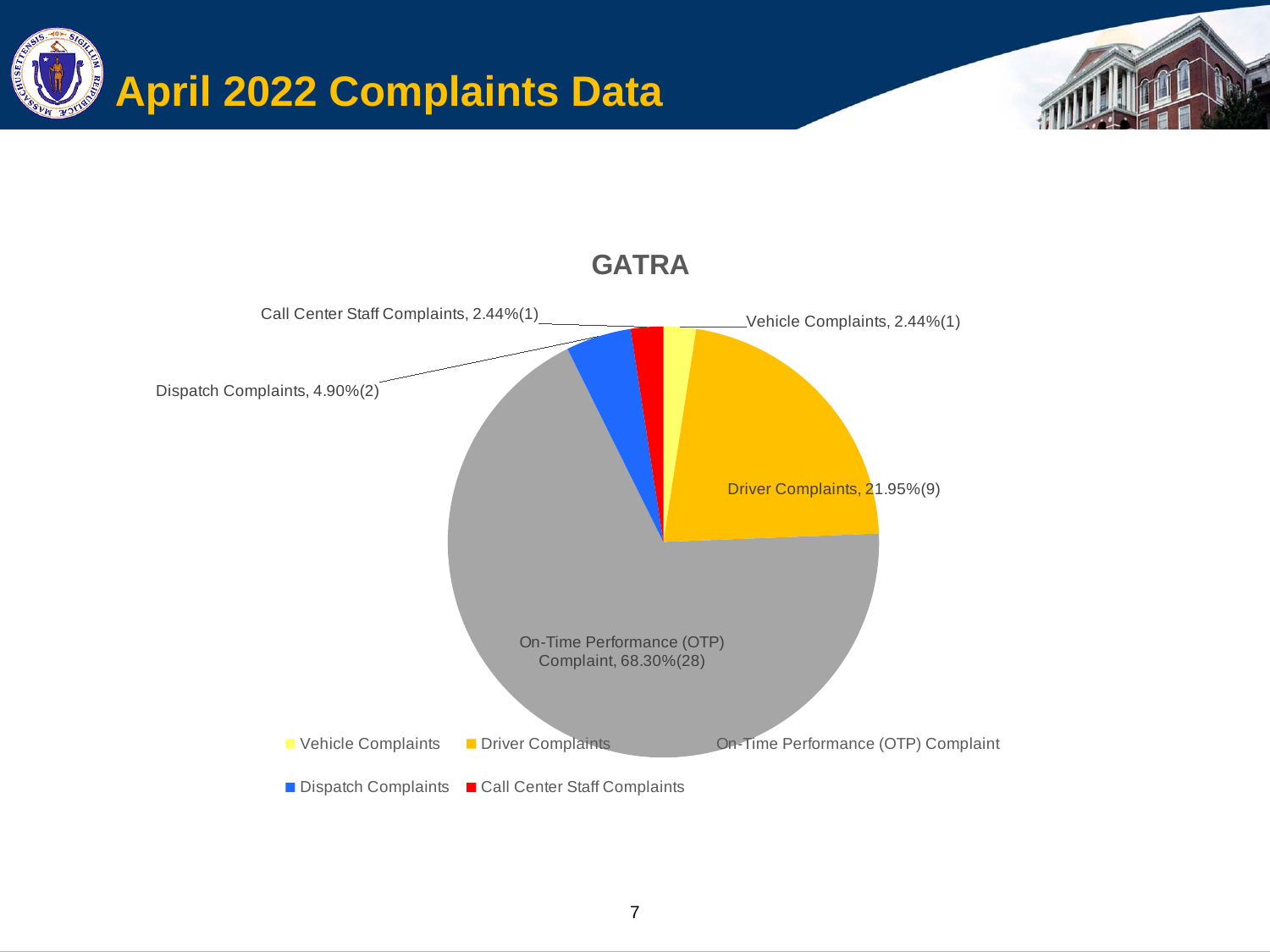
Which category has the largest slice of the pie? On-Time Performance (OTP) Complaint What kind of chart is shown on the slide? pie chart How many categories does the pie chart have? 5 What share of the pie is Driver Complaints? 21.95% Which is larger, Driver Complaints or Dispatch Complaints? Driver Complaints What share of the pie is On-Time Performance (OTP) Complaint? 68.30% How many more complaints are there for On-Time Performance (OTP) Complaint than for Driver Complaints? 19 How many complaints are shown for On-Time Performance (OTP) Complaint? 28 How many complaints are shown for Call Center Staff Complaints? 1 What is the title of the chart? GATRA How many complaints are shown for Driver Complaints? 9 What share of the pie is Dispatch Complaints? 4.90%